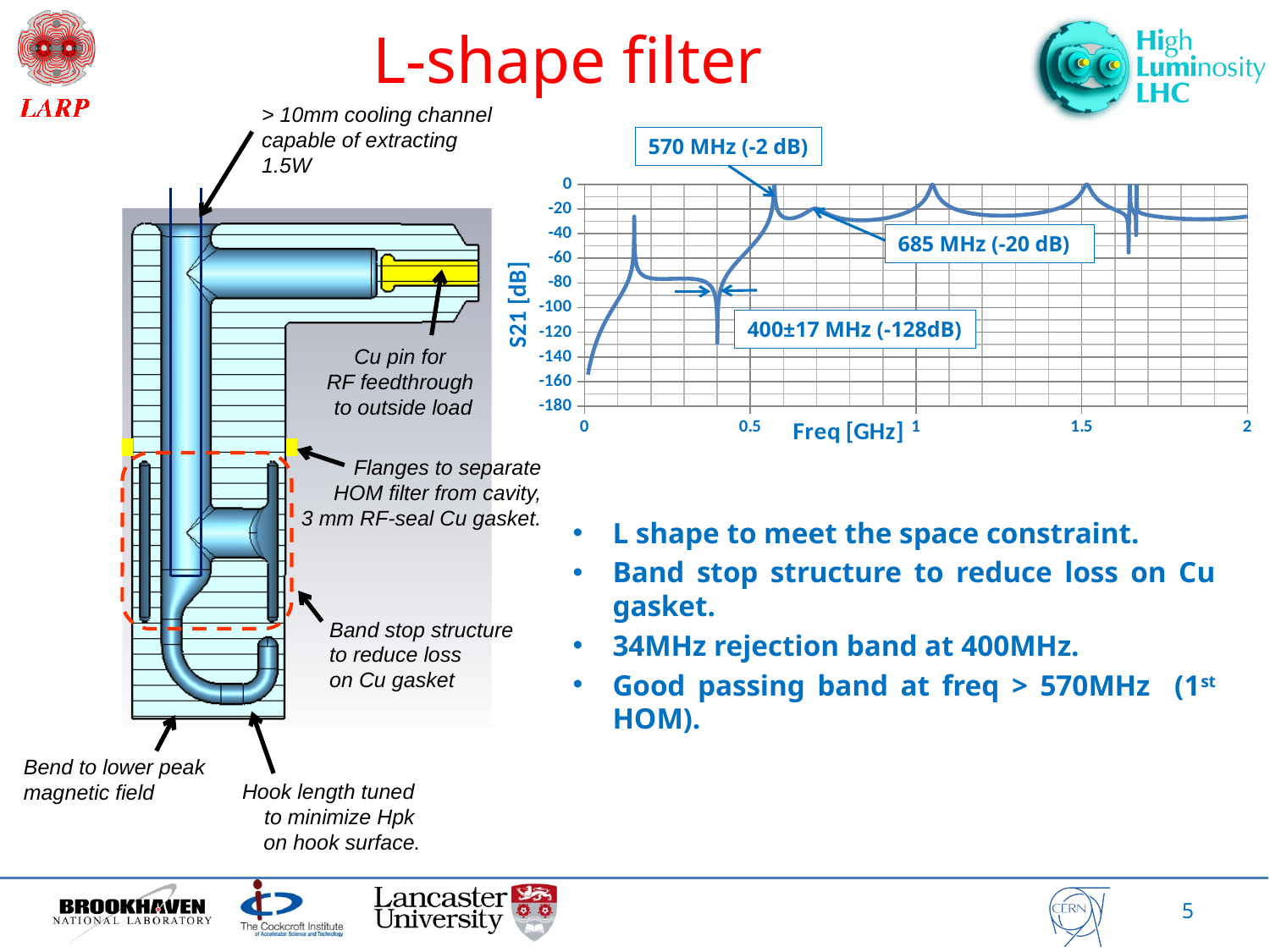
What is the label of the x axis of the chart? Freq [GHz] What is the difference in S21 between the annotated points at 570 MHz and 400±17 MHz? 126 dB What is the label of the y axis of the chart? S21 [dB] Which annotated point has a larger S21 value, 685 MHz or 400±17 MHz? 685 MHz Is the S21 value at 1.5 GHz greater or less than -40 dB? greater Of the three annotated points, which frequency has the highest S21 value? 570 MHz What is the difference in S21 between the annotated points at 570 MHz and 685 MHz? 18 dB What is the S21 value annotated at 685 MHz? -20 dB What kind of chart is shown on the right of the slide? line chart What is the S21 value annotated at 570 MHz? -2 dB Of the three annotated points, which frequency has the lowest S21 value? 400±17 MHz What is the S21 value annotated at 400±17 MHz? -128dB